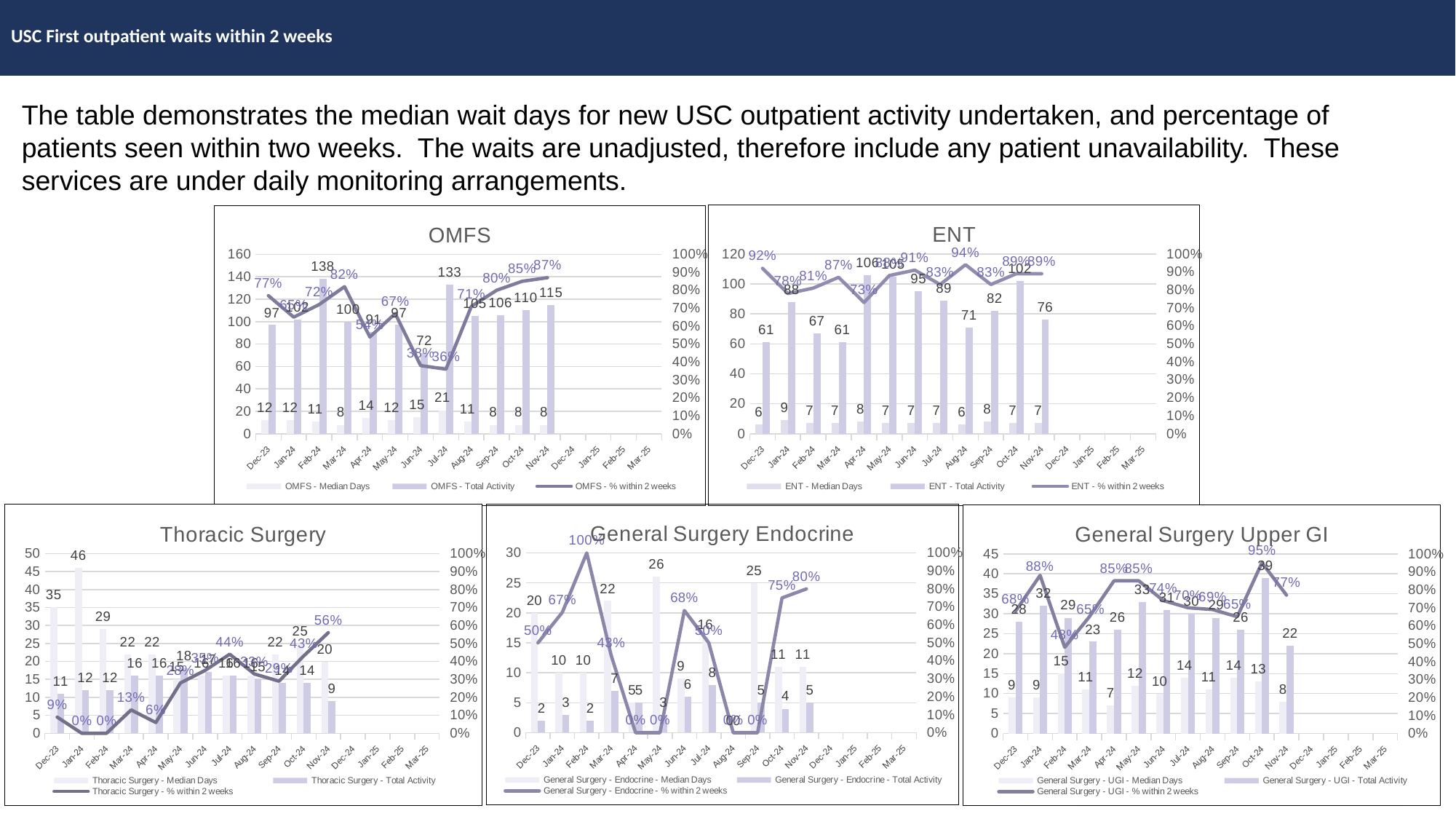
In the ENT chart, what is the % within 2 weeks for Aug-24? 94% In the OMFS chart, what is the Total Activity value for Feb-24? 138 In the General Surgery Endocrine chart, what is the % within 2 weeks for Feb-24? 100% In the OMFS chart, what is the % within 2 weeks for Nov-24? 87% In the OMFS chart, what is the Median Days value for Jul-24? 21 How many charts are shown on the slide? 5 In the OMFS chart, which month has the highest Total Activity? Feb-24 In the Thoracic Surgery chart, what is the Median Days value for Jan-24? 46 In the OMFS chart, what is the difference in Total Activity between Feb-24 and Jun-24? 66 In the ENT chart, which is larger, the Total Activity for Apr-24 or for Nov-24? Apr-24 In the General Surgery Upper GI chart, what is the % within 2 weeks for Oct-24? 95% How many series does the legend of the ENT chart list? 3